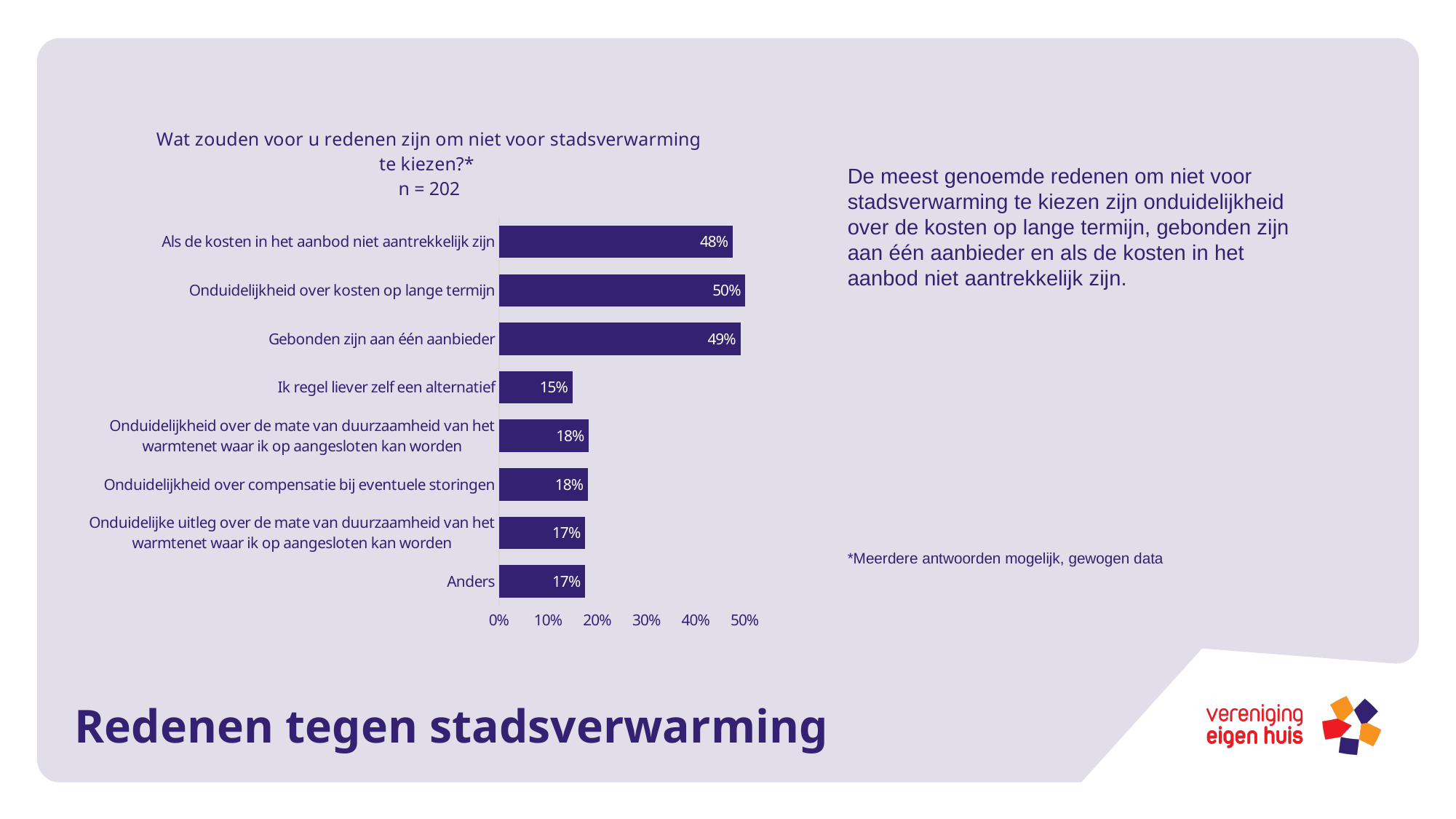
What is the value for 'Ik regel liever zelf een alternatief'? 15% Which reason has the highest percentage? Onduidelijkheid over kosten op lange termijn What is the difference between 'Gebonden zijn aan één aanbieder' and 'Ik regel liever zelf een alternatief'? 34% Which reason has the lowest percentage? Ik regel liever zelf een alternatief What is the sample size (n) stated in the chart title? 202 What is the value for 'Gebonden zijn aan één aanbieder'? 49% What is the difference between 'Onduidelijkheid over kosten op lange termijn' and 'Als de kosten in het aanbod niet aantrekkelijk zijn'? 2% What is the value for 'Anders'? 17% Which is larger: 'Onduidelijkheid over compensatie bij eventuele storingen' or 'Anders'? Onduidelijkheid over compensatie bij eventuele storingen What kind of chart is shown on the slide? Bar chart What percentage of respondents chose 'Onduidelijkheid over kosten op lange termijn' as a reason? 50% How many reasons (categories) are shown in the chart? 8